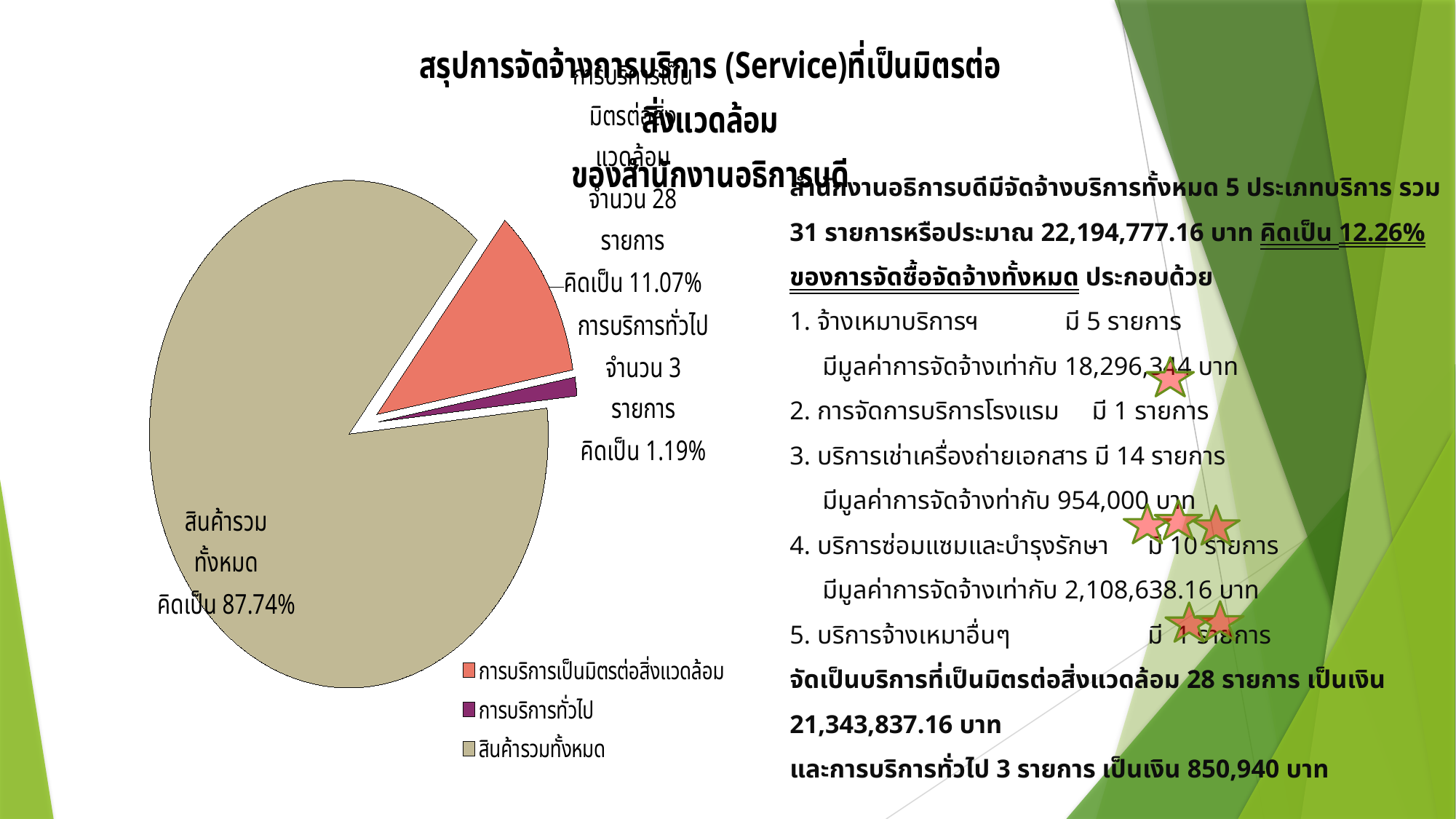
What percentage share does the slice การบริการเป็นมิตรต่อสิ่งแวดล้อม have in the pie chart? 11.07% Which slice of the pie chart is the smallest? การบริการทั่วไป How many items (รายการ) does the label for การบริการทั่วไป show? 3 รายการ How many entries does the legend of the pie chart list? 3 What is the difference in percentage between the การบริการเป็นมิตรต่อสิ่งแวดล้อม slice and the การบริการทั่วไป slice? 9.88% What percentage share does the slice สินค้ารวมทั้งหมด have in the pie chart? 87.74% How many slices does the pie chart have? 3 What kind of chart is shown on the slide? pie chart Which slice of the pie chart is the largest? สินค้ารวมทั้งหมด How many items (รายการ) does the label for การบริการเป็นมิตรต่อสิ่งแวดล้อม show? 28 รายการ What percentage share does the slice การบริการทั่วไป have in the pie chart? 1.19% Which colour is used for the การบริการทั่วไป slice in the pie chart? purple